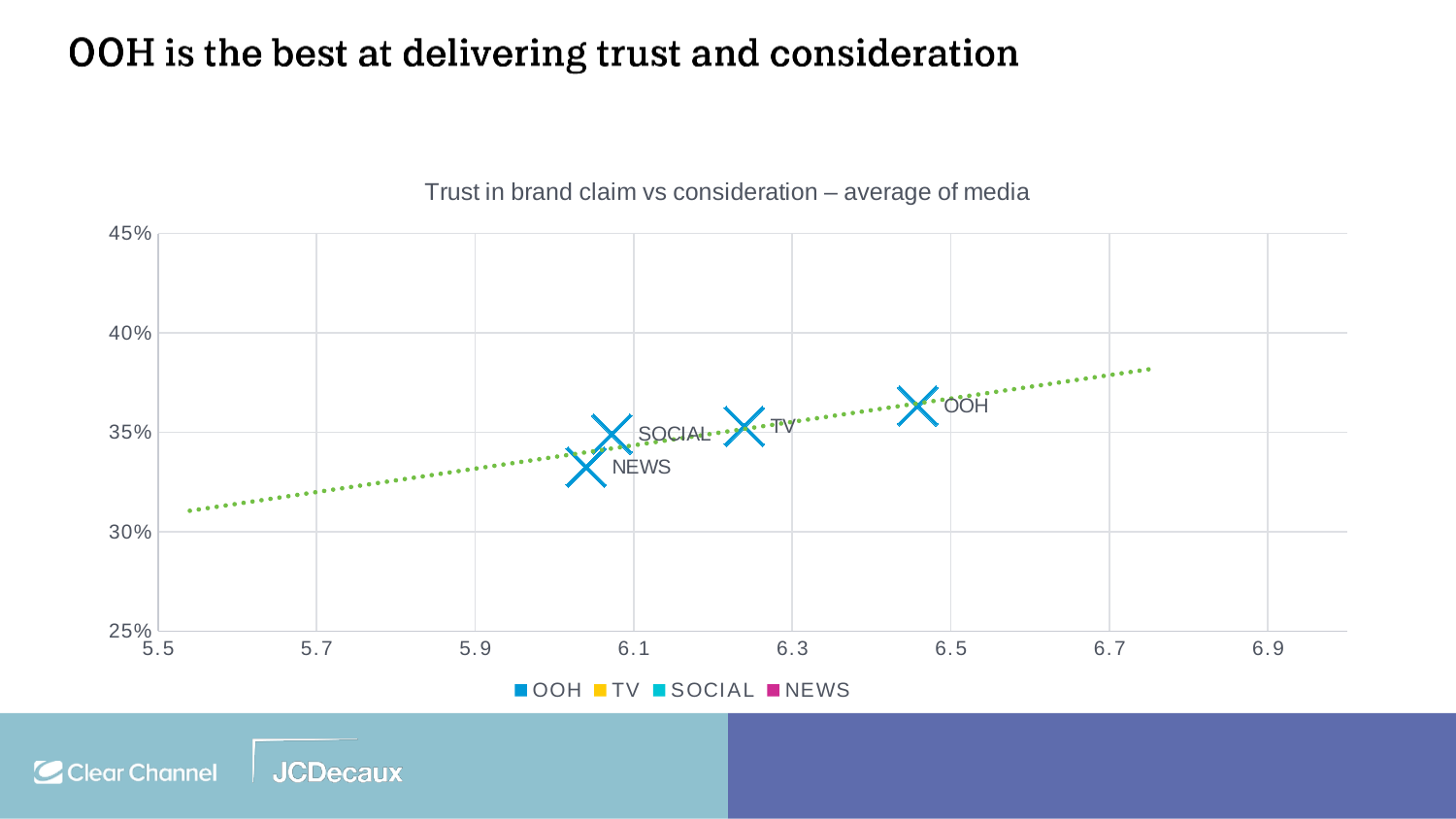
What kind of chart is shown on the slide? Scatter chart Does the dotted trend line rise or fall as trust increases along the x axis? Rises How many series does the legend list? 4 Is the trust value for OOH greater or less than 6.3? greater Which medium has the highest trust value (horizontal axis)? OOH Which medium has the highest consideration value (vertical axis)? OOH What is the title of the chart? Trust in brand claim vs consideration – average of media Is the consideration value for OOH greater or less than 35%? greater Which medium has the lowest consideration value (vertical axis)? NEWS Is the consideration value for NEWS greater or less than 35%? less How many data points are plotted on the chart? 4 Which has the higher consideration value, OOH or NEWS? OOH